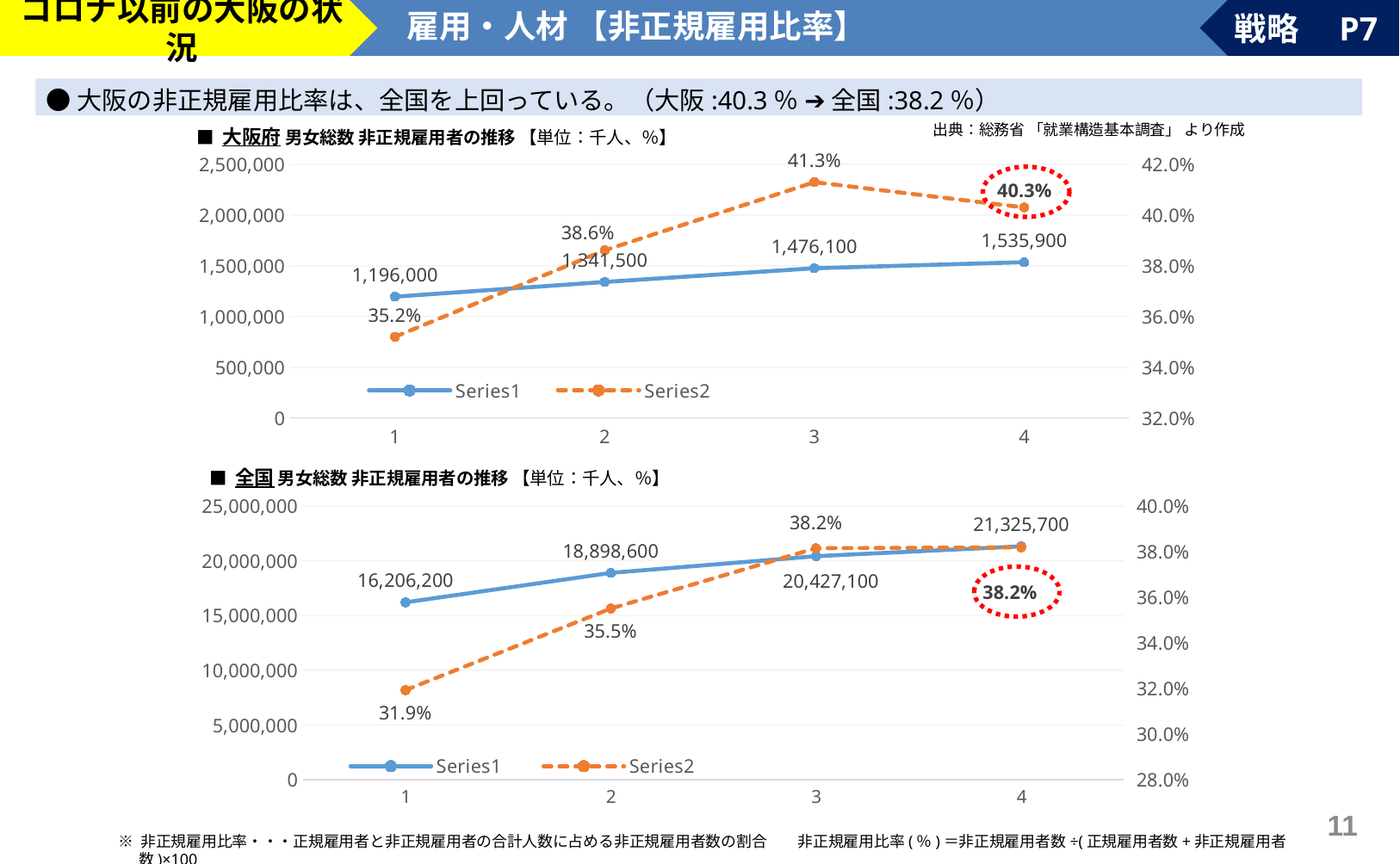
In the 全国 chart (bottom), what is the Series1 value at point 2? 18,898,600 In the 大阪府 chart (top), what is the Series2 value at point 3? 41.3% In the 大阪府 chart (top), does Series1 rise or fall from point 1 to point 4? rise In the 大阪府 chart (top), what is the difference between the Series1 values at point 4 and point 1? 339,900 In the 全国 chart (bottom), which is larger, the Series1 value at point 3 or at point 4? point 4 What type of chart is the 大阪府 chart (top)? line chart In the 全国 chart (bottom), what is the Series2 value at point 1? 31.9% How many series does the legend of the 全国 chart (bottom) list? 2 In the 大阪府 chart (top), at which x-axis point is Series2 lowest? 1 In the 大阪府 chart (top), at which x-axis point is Series2 highest? 3 In the 全国 chart (bottom), what is the difference between the Series2 values at point 2 and point 1? 3.6% In the 大阪府 chart (top), what is the Series1 value at point 1? 1,196,000